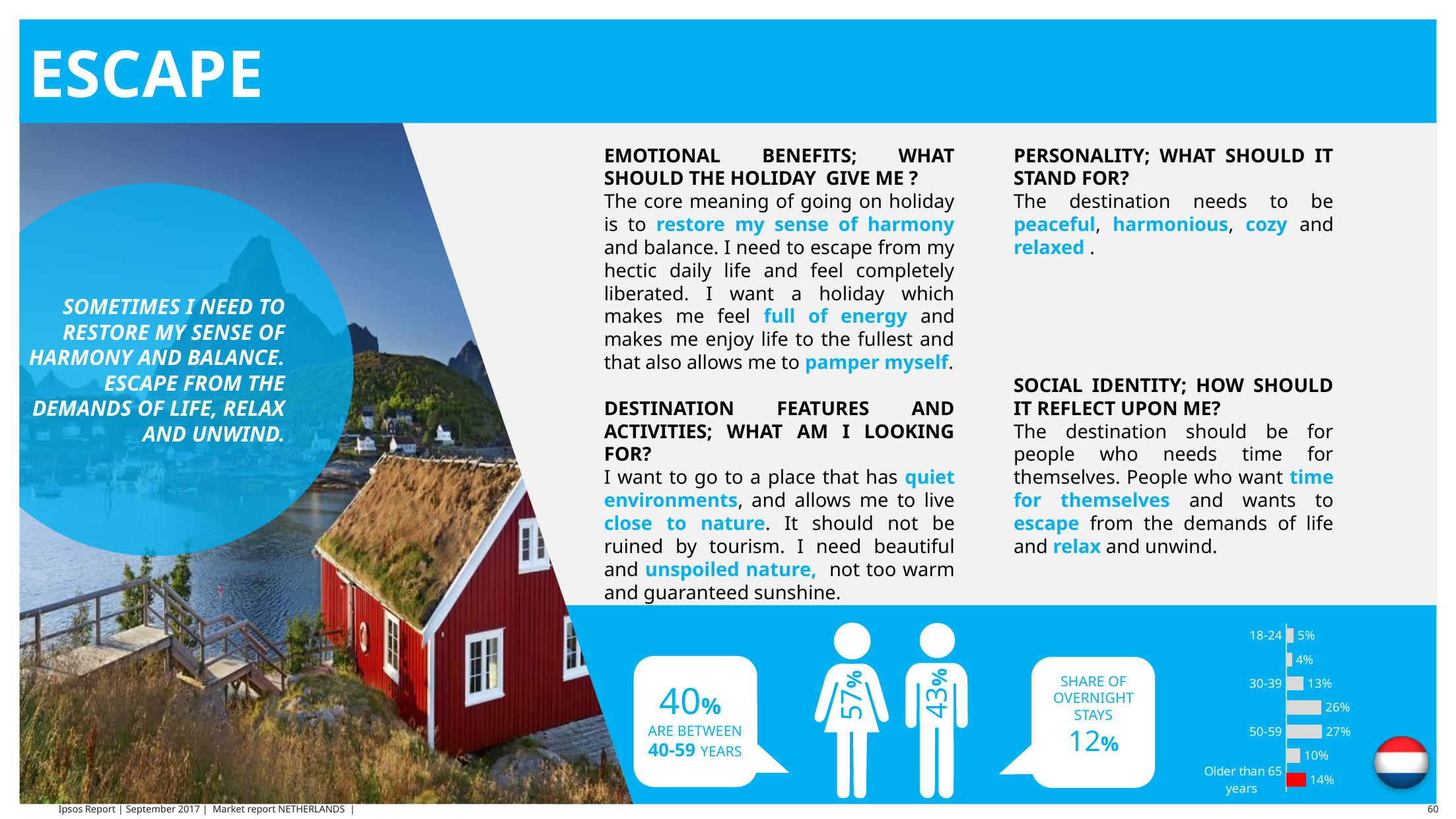
Which has a larger value, the 18-24 group or the 'Older than 65 years' group? Older than 65 years What is the value for the 50-59 age group in the bar chart? 27% What is the value for the 30-39 age group in the bar chart? 13% What kind of chart is shown in the bottom right of the slide? Bar chart How many bars does the age-group chart contain? 7 What is the difference between the values for the 'Older than 65 years' and 18-24 groups? 9 percentage points What is the value for the 18-24 age group in the bar chart? 5% Which age group's bar is coloured red in the chart? Older than 65 years What is the value for the 'Older than 65 years' group in the bar chart? 14% Is the value for the 50-59 group greater or less than 20%? greater Which has a larger value, the 50-59 group or the 30-39 group? 50-59 What is the difference between the values for the 50-59 and 30-39 age groups? 14 percentage points